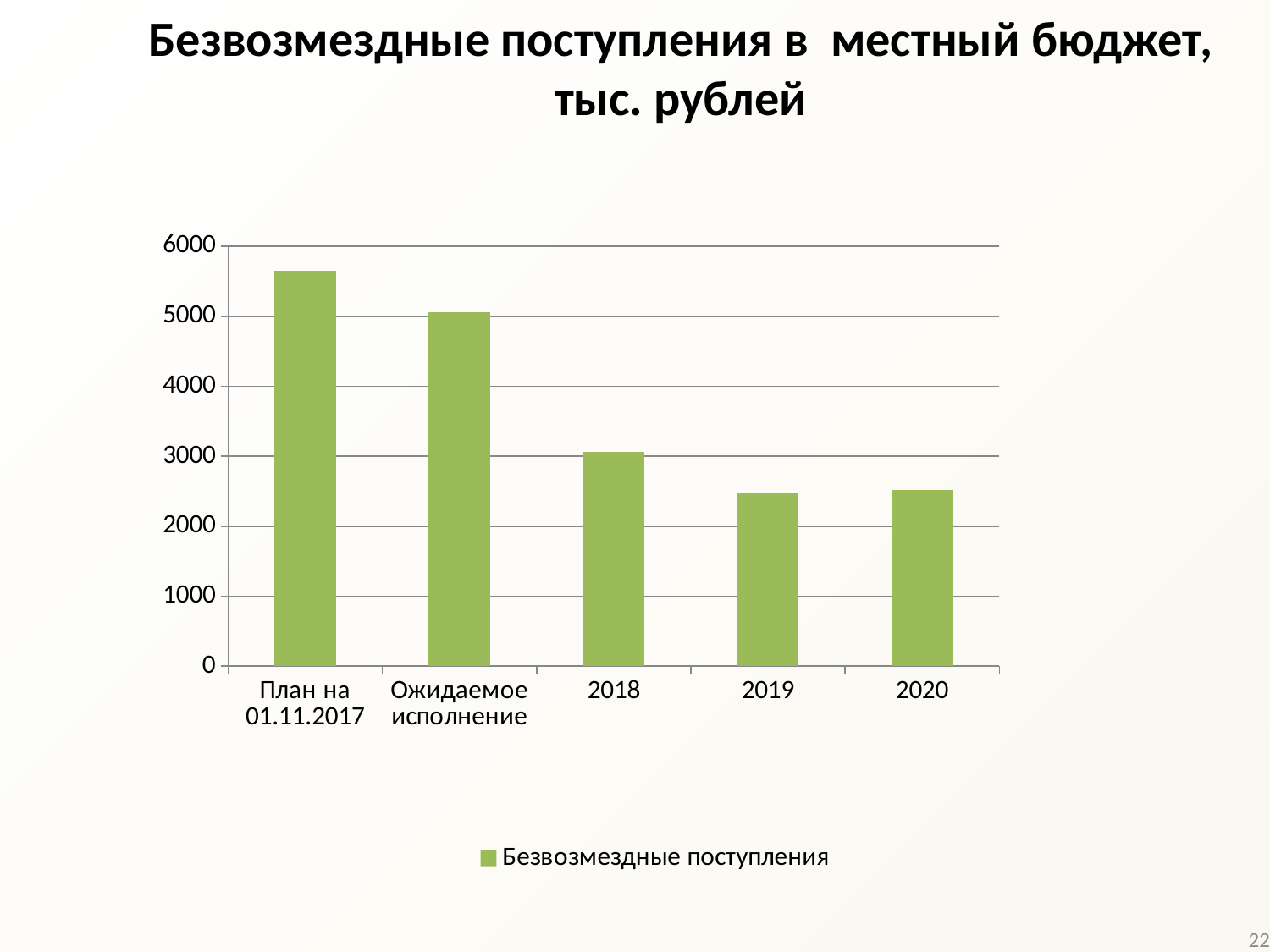
How many series does the legend list? 1 Which category has the highest value? План на 01.11.2017 Is the value for 2020 greater or less than 2000? greater Is the value for 2018 greater or less than 4000? less Is the value for 2019 greater or less than 3000? less Do the values rise or fall from План на 01.11.2017 to 2019? fall What is the series name shown in the legend? Безвозмездные поступления How many categories are shown on the x axis? 5 What kind of chart is shown on the slide? bar chart Which is larger, the value for 2018 or the value for 2019? 2018 Which is larger, the value for План на 01.11.2017 or the value for Ожидаемое исполнение? План на 01.11.2017